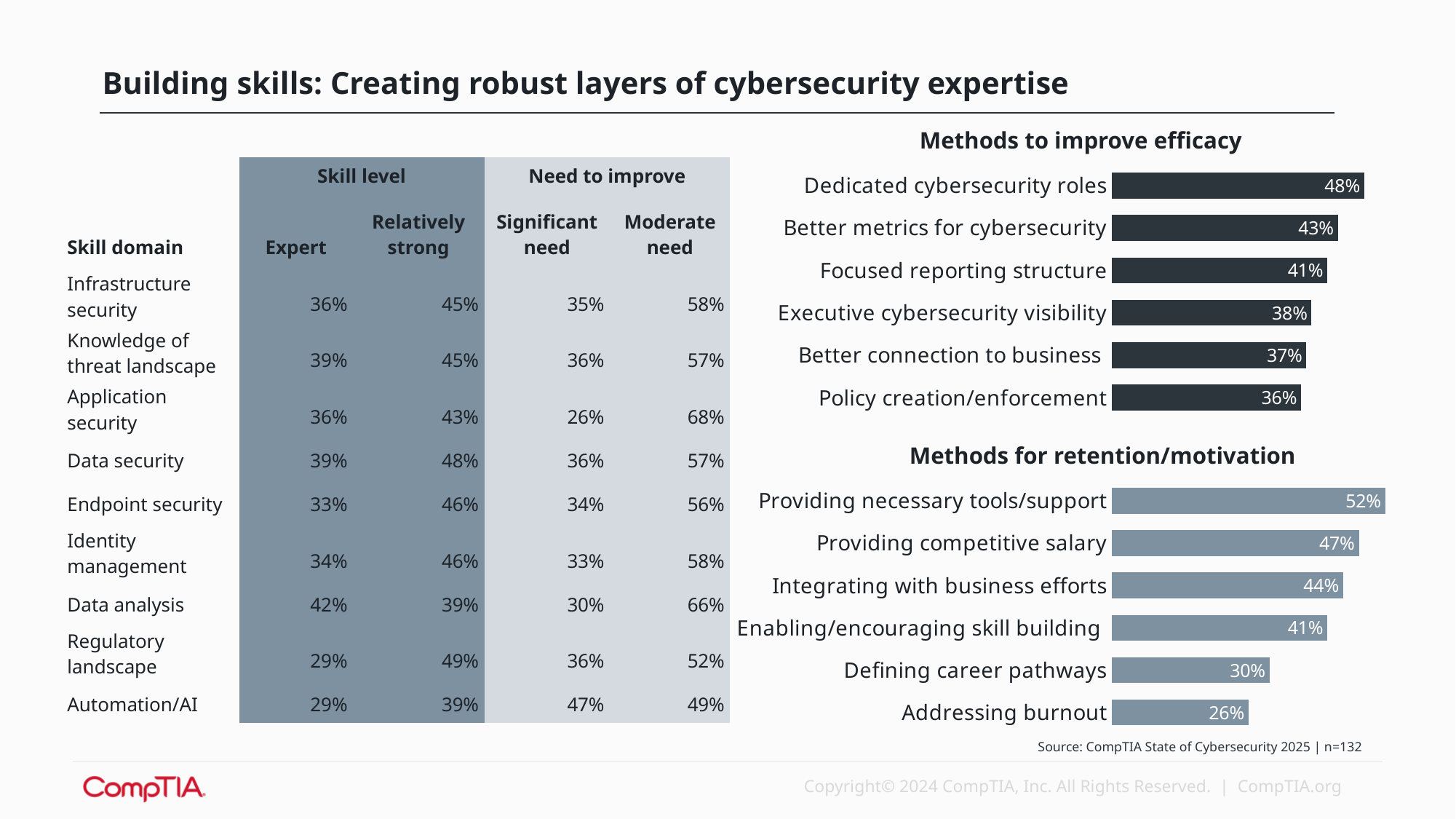
In the 'Methods to improve efficacy' chart, what is the difference between Dedicated cybersecurity roles and Focused reporting structure? 7% In the 'Methods to improve efficacy' chart, what is the value for Dedicated cybersecurity roles? 48% What type of chart is 'Methods for retention/motivation'? Bar chart In the 'Methods for retention/motivation' chart, do the values rise or fall from top to bottom? Fall In the 'Methods for retention/motivation' chart, what is the difference between Providing necessary tools/support and Addressing burnout? 26% In the 'Methods for retention/motivation' chart, which method has the highest value? Providing necessary tools/support In the 'Methods to improve efficacy' chart, which method has the lowest value? Policy creation/enforcement In the 'Methods for retention/motivation' chart, which is larger: Defining career pathways or Addressing burnout? Defining career pathways In the 'Methods to improve efficacy' chart, what is the value for Better connection to business? 37% What is the title of the upper chart on the right side of the slide? Methods to improve efficacy How many categories are shown in the 'Methods to improve efficacy' chart? 6 In the 'Methods for retention/motivation' chart, what is the value for Providing competitive salary? 47%